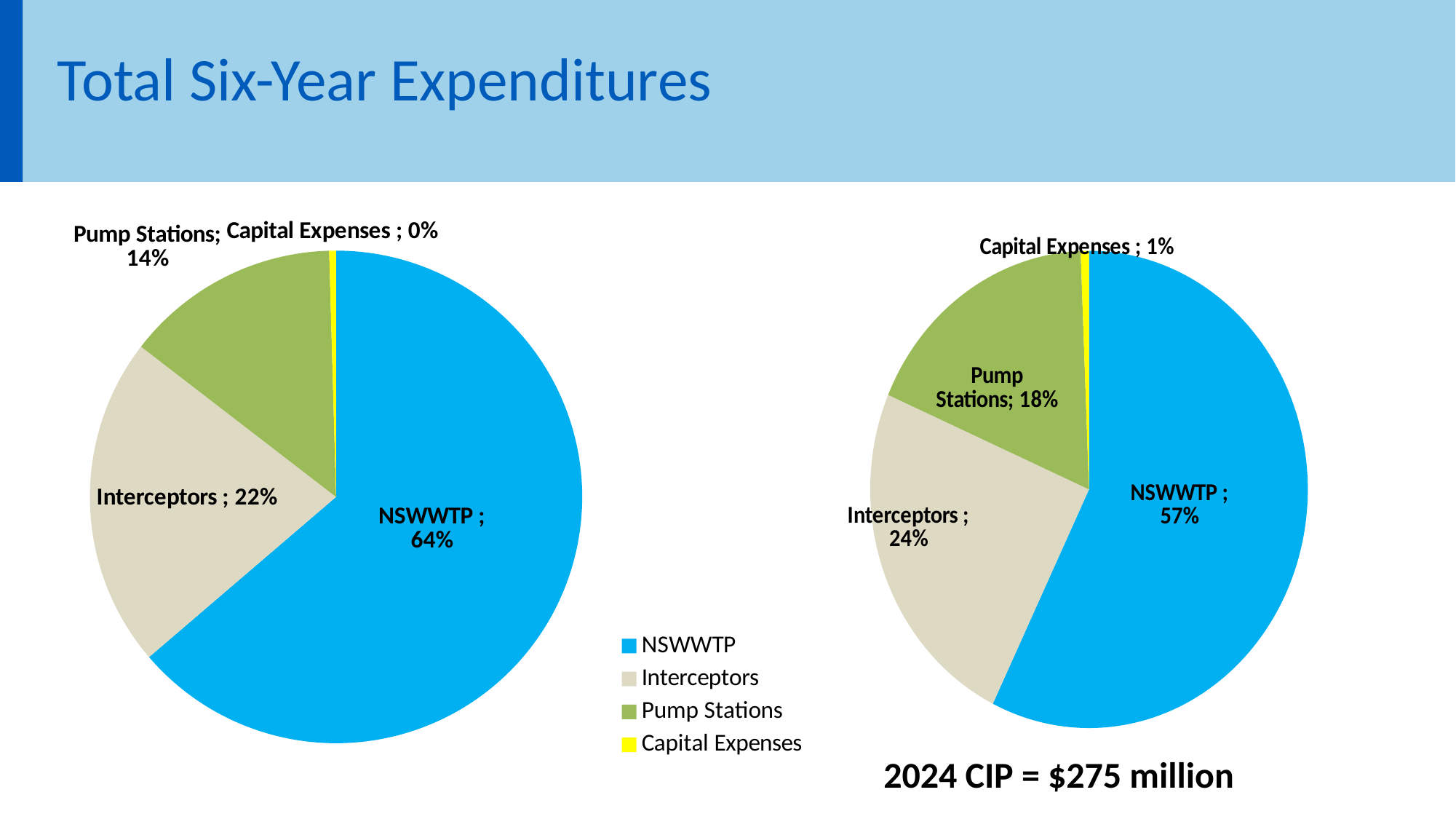
How many entries does the legend list? 4 What type of chart is shown on the left of the slide? Pie chart In the right pie chart, what share does Interceptors have? 24% In the right pie chart, what share does Pump Stations have? 18% What is the title of the slide? Total Six-Year Expenditures In the left pie chart, what share does Capital Expenses have? 0% In the left pie chart, what share does NSWWTP have? 64% In the right pie chart, which category has the smallest slice? Capital Expenses In the left pie chart, which category has the largest slice? NSWWTP In the right pie chart, which is larger, Interceptors or Pump Stations? Interceptors How many slices does the right pie chart have? 4 In the left pie chart, what is the difference between the Interceptors share and the Pump Stations share? 8%